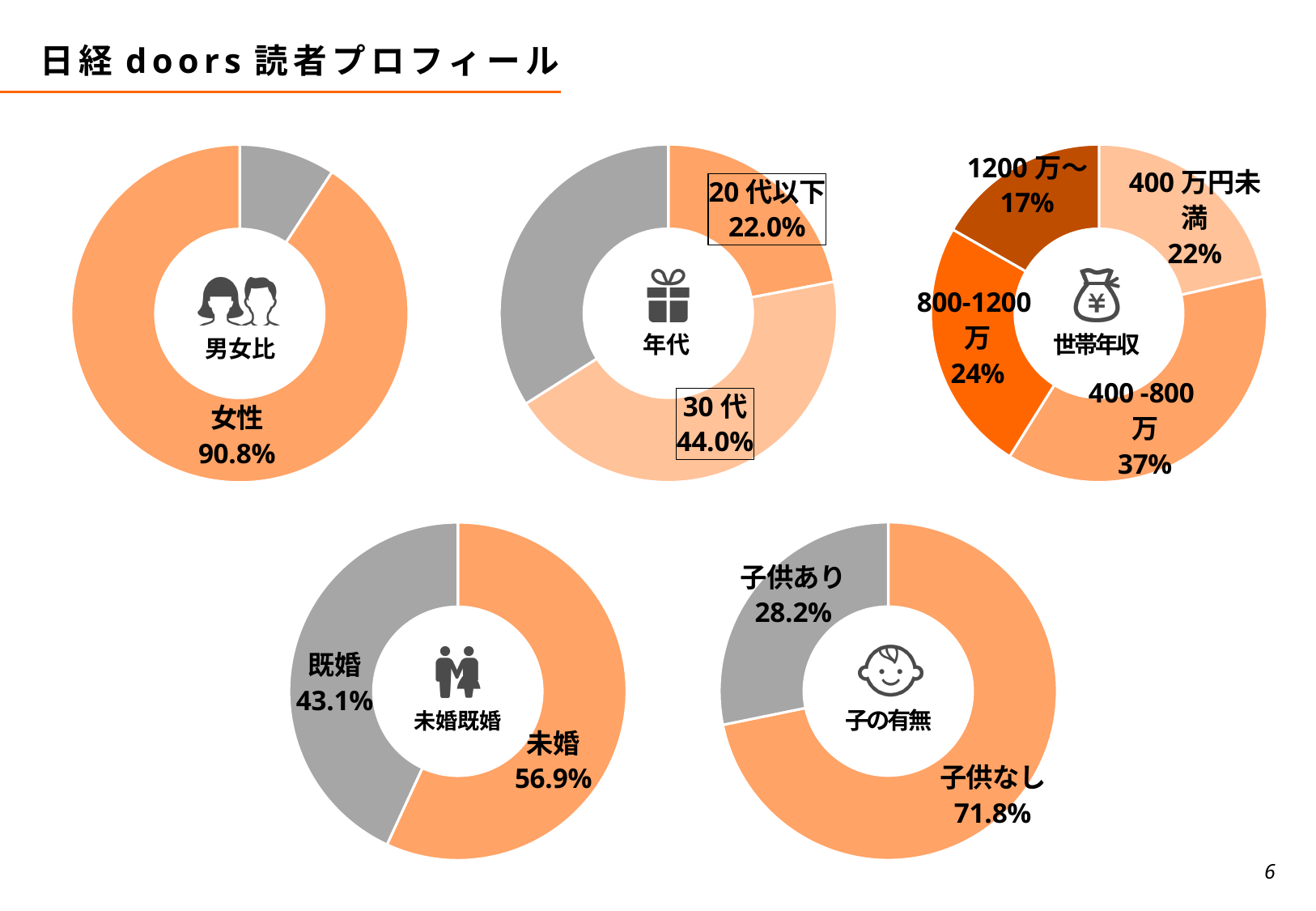
In the 男女比 chart, what share is labelled for 女性? 90.8% In the 未婚既婚 chart, which is larger, 未婚 or 既婚? 未婚 In the 世帯年収 chart, which labelled income band has the largest share? 400-800万 In the 子の有無 chart, what share is labelled for 子供あり? 28.2% What kind of chart is the 子の有無 chart? Donut (pie) chart In the 世帯年収 chart, what share is labelled for 400-800万? 37% In the 世帯年収 chart, which labelled income band has the smallest share? 1200万〜 In the 年代 chart, what share is labelled for 20代以下? 22.0% In the 未婚既婚 chart, what is the difference between the 未婚 and 既婚 shares? 13.8% In the 世帯年収 chart, what is the difference between the shares for 800-1200万 and 1200万〜? 7% In the 年代 chart, what share is labelled for 30代? 44.0% How many donut charts are shown on the slide? 5